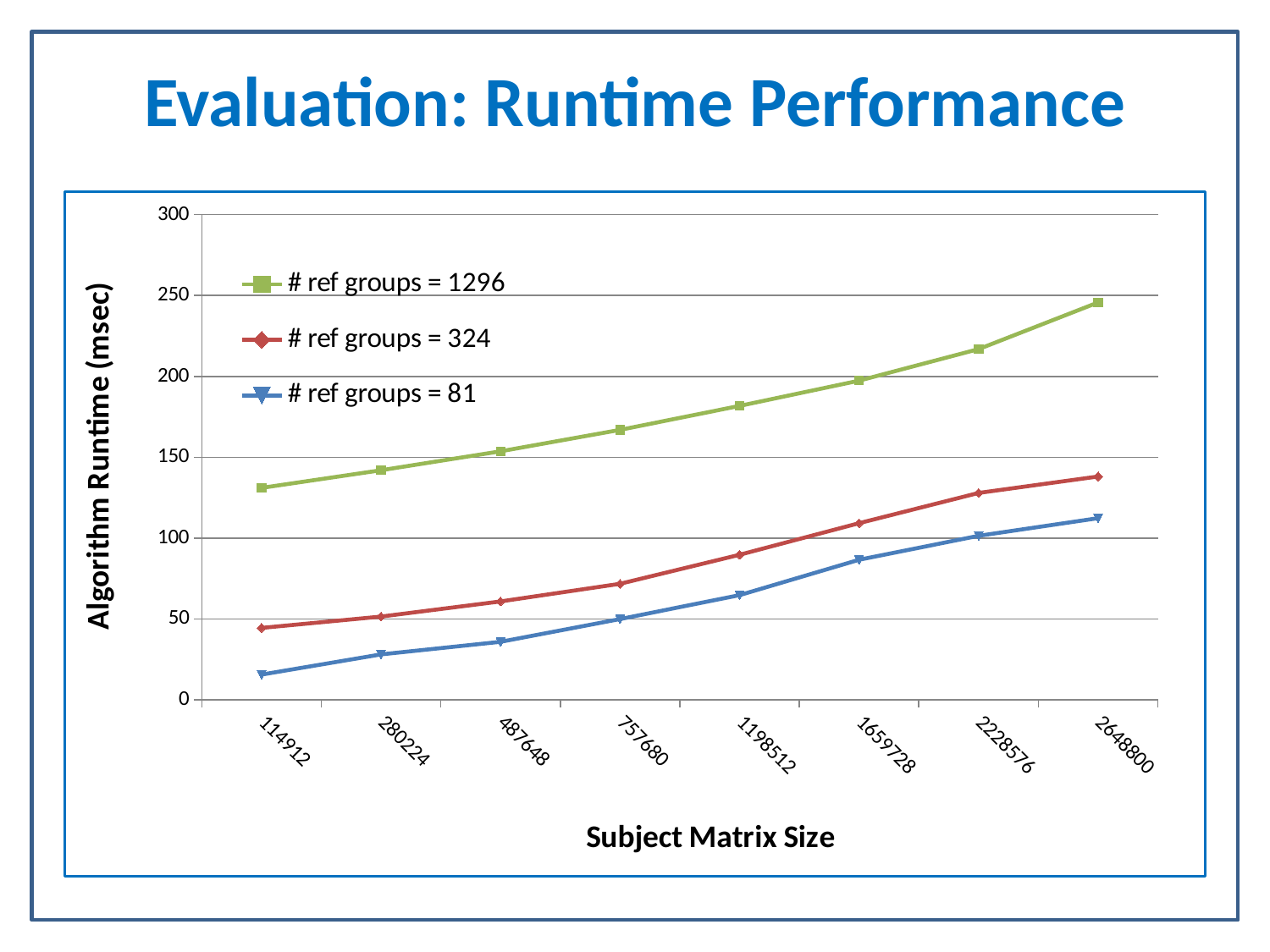
Does the runtime for # ref groups = 1296 rise or fall as the subject matrix size increases? rise How many series does the legend list? 3 Is the runtime for # ref groups = 81 at subject matrix size 114912 greater or less than 50? less What is the label of the x axis? Subject Matrix Size What is the label of the y axis? Algorithm Runtime (msec) Is the runtime for # ref groups = 1296 at subject matrix size 2648800 greater or less than 200? greater Which series has the lowest runtime at subject matrix size 114912? # ref groups = 81 Which series has the highest runtime at subject matrix size 2648800? # ref groups = 1296 Which is larger at subject matrix size 1659728: the runtime for # ref groups = 324 or for # ref groups = 81? # ref groups = 324 How many subject matrix sizes are plotted along the x axis? 8 Is the runtime for # ref groups = 324 at subject matrix size 2648800 greater or less than 150? less What kind of chart is shown on the slide? line chart